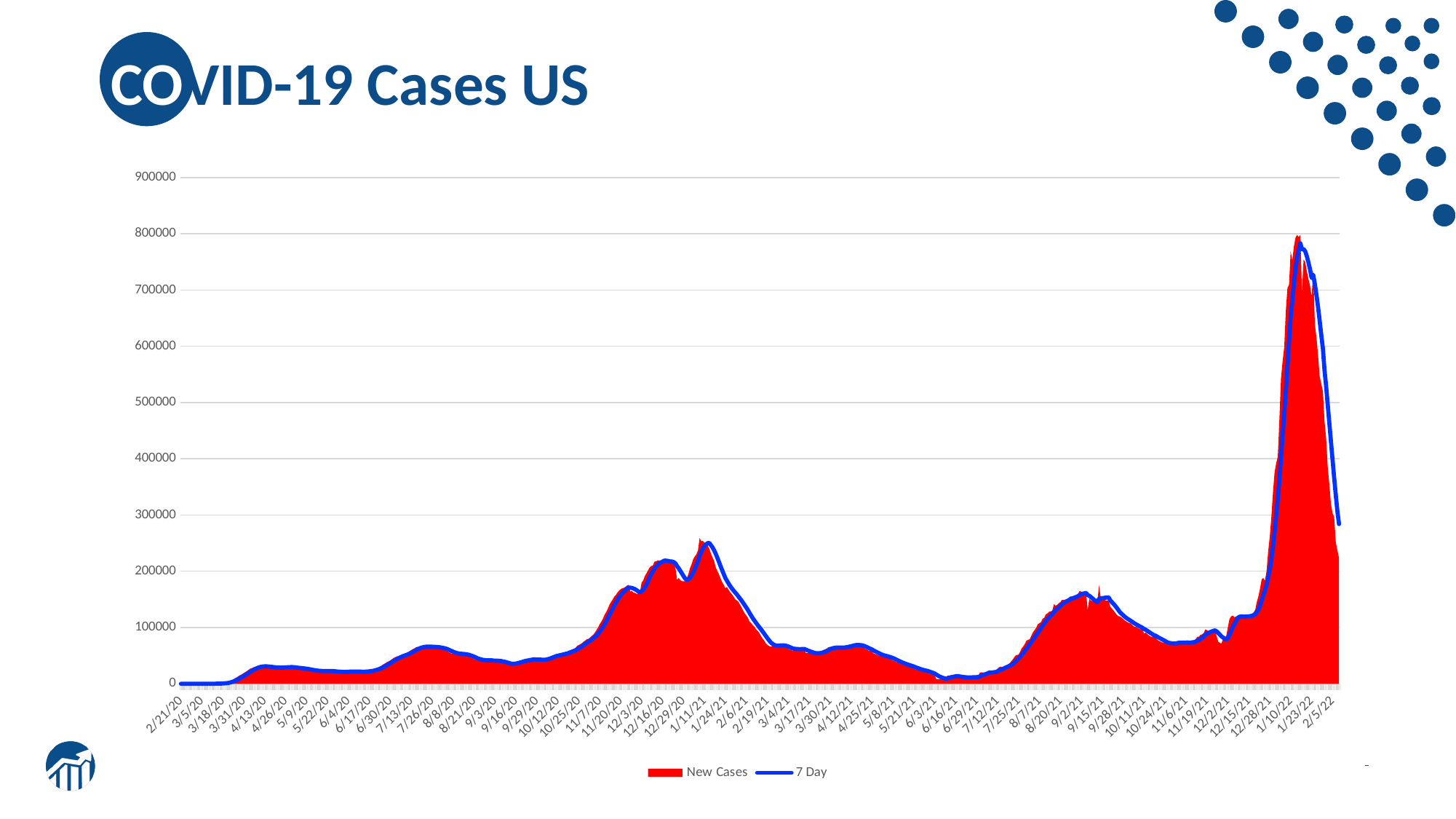
What kind of chart is shown on the slide? Area chart with a line overlay What are the two series named in the legend? New Cases and 7 Day Which is larger, the 7 Day value around 1/11/21 or the 7 Day value around 9/2/21? 1/11/21 Does the 7 Day line rise or fall between 1/23/22 and 2/5/22? fall Is the value of the 7 Day line around 6/16/21 greater or less than 100000? less Is the peak value of the 7 Day line around 1/10/22 greater or less than 700000? greater What is the title of the chart? COVID-19 Cases US Is the value of the 7 Day line around 1/11/21 greater or less than 200000? greater Around which date does the 7 Day line reach its highest value? 1/10/22 How many series does the legend list? 2